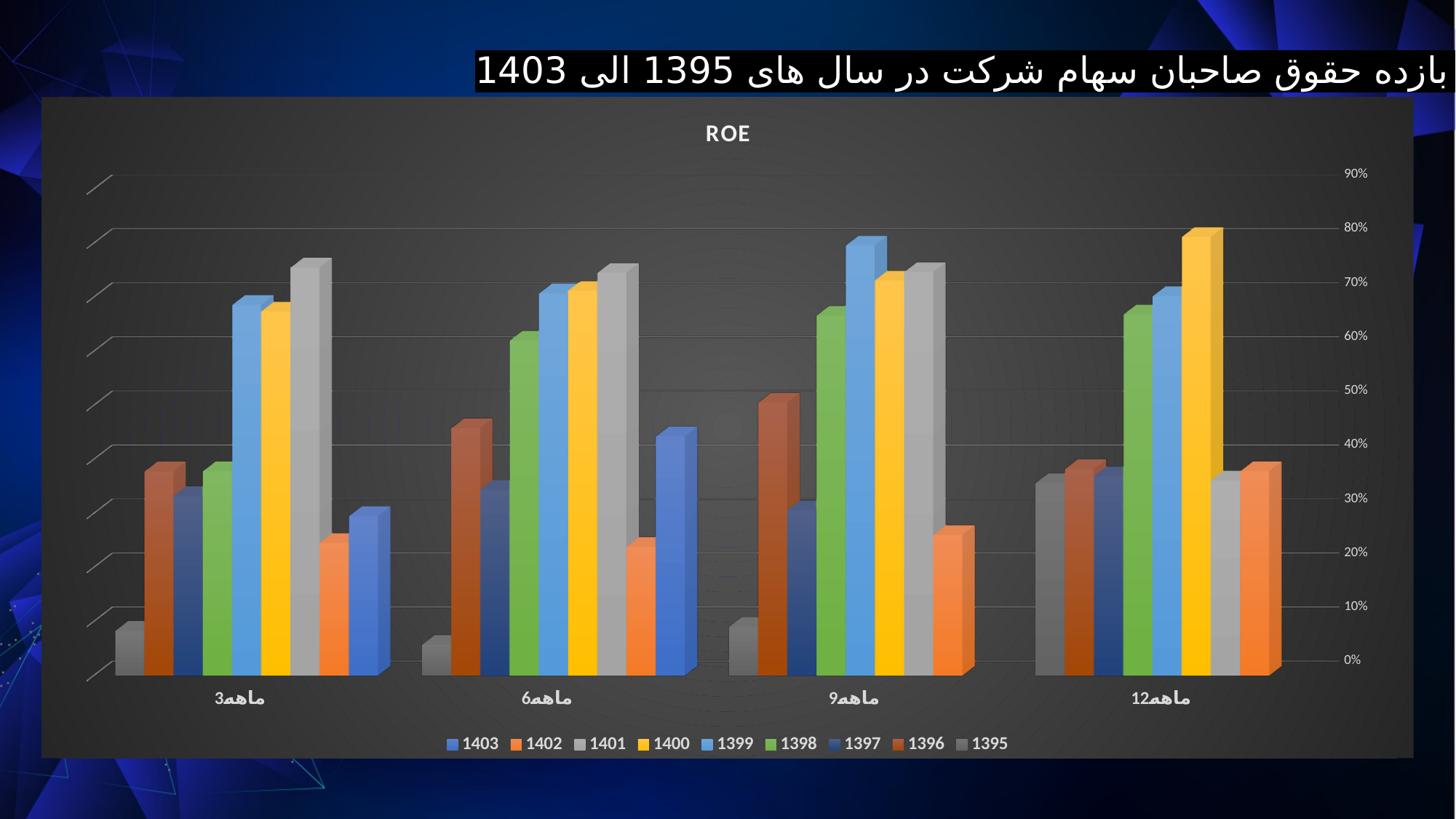
How many series does the legend list? 9 In the 9ماهه category, which is larger: the value for 1396 or the value for 1402? 1396 Do the values for the 1400 series rise or fall from 3ماهه to 12ماهه? rise What is the title of the chart? ROE Which series has the lowest value in the 3ماهه category? 1395 How many categories are shown on the x axis? 4 What kind of chart is shown on the slide? bar chart Is the value for 1402 in the 6ماهه category greater or less than 30%? less Is the value for 1400 in the 12ماهه category greater or less than 70%? greater Which series has the highest value in the 9ماهه category? 1399 Is the value for 1395 in the 3ماهه category greater or less than 10%? less Which series has the highest value in the 12ماهه category? 1400